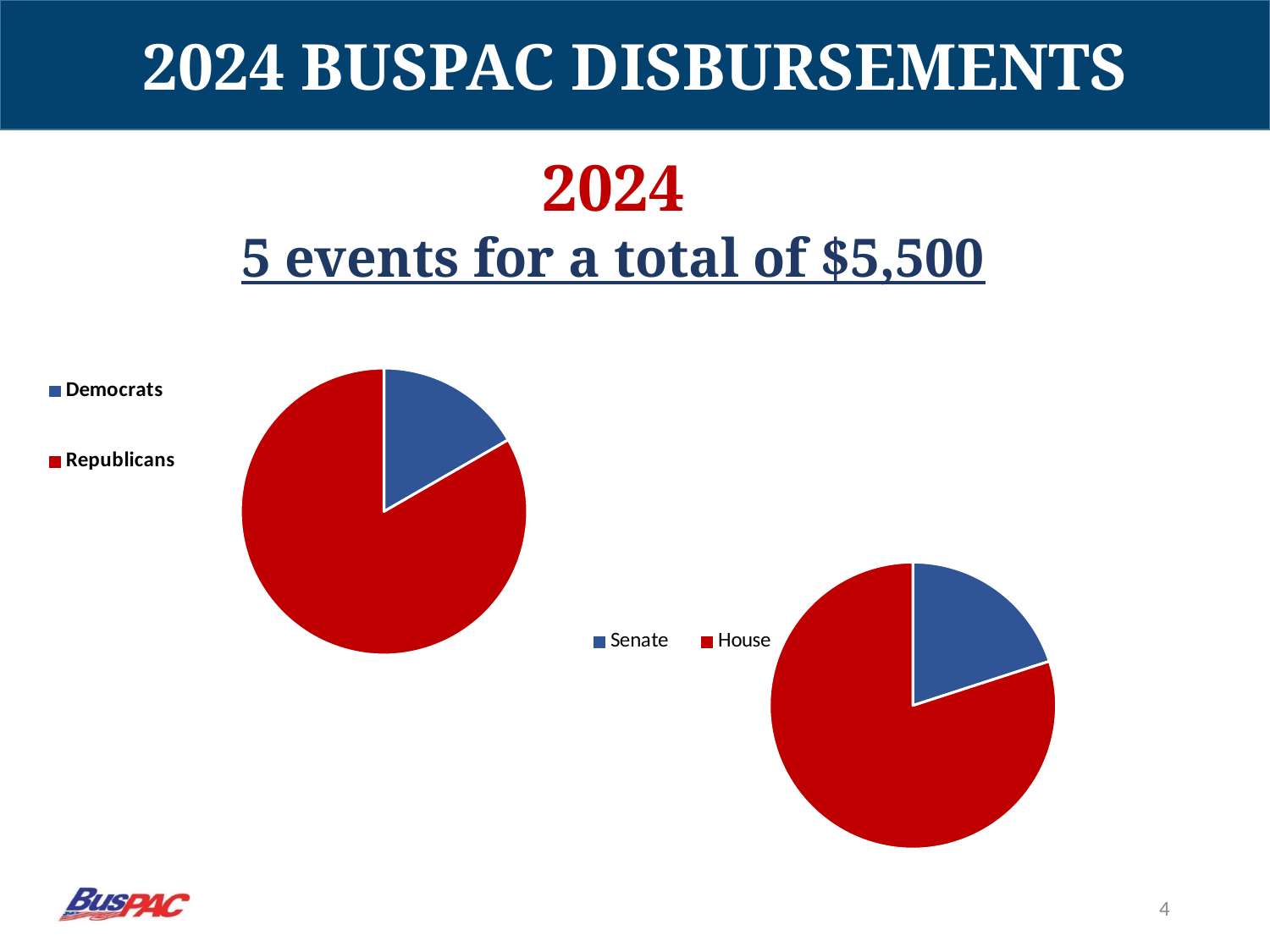
What kind of chart is the left chart with the Democrats and Republicans legend? pie chart How many entries does the legend of the right pie chart list? 2 In the left pie chart, which category has the smallest slice? Democrats In the left pie chart, what colour is the Democrats slice? blue In the right pie chart, which category has the largest slice? House How many slices does the left pie chart have? 2 What kind of chart is the right chart with the Senate and House legend? pie chart In the left pie chart, which category has the largest slice? Republicans In the left pie chart, is the Democrats slice larger or smaller than the Republicans slice? smaller In the right pie chart, is the House slice larger or smaller than the Senate slice? larger In the right pie chart, what colour is the House slice? red In the right pie chart, which category has the smallest slice? Senate